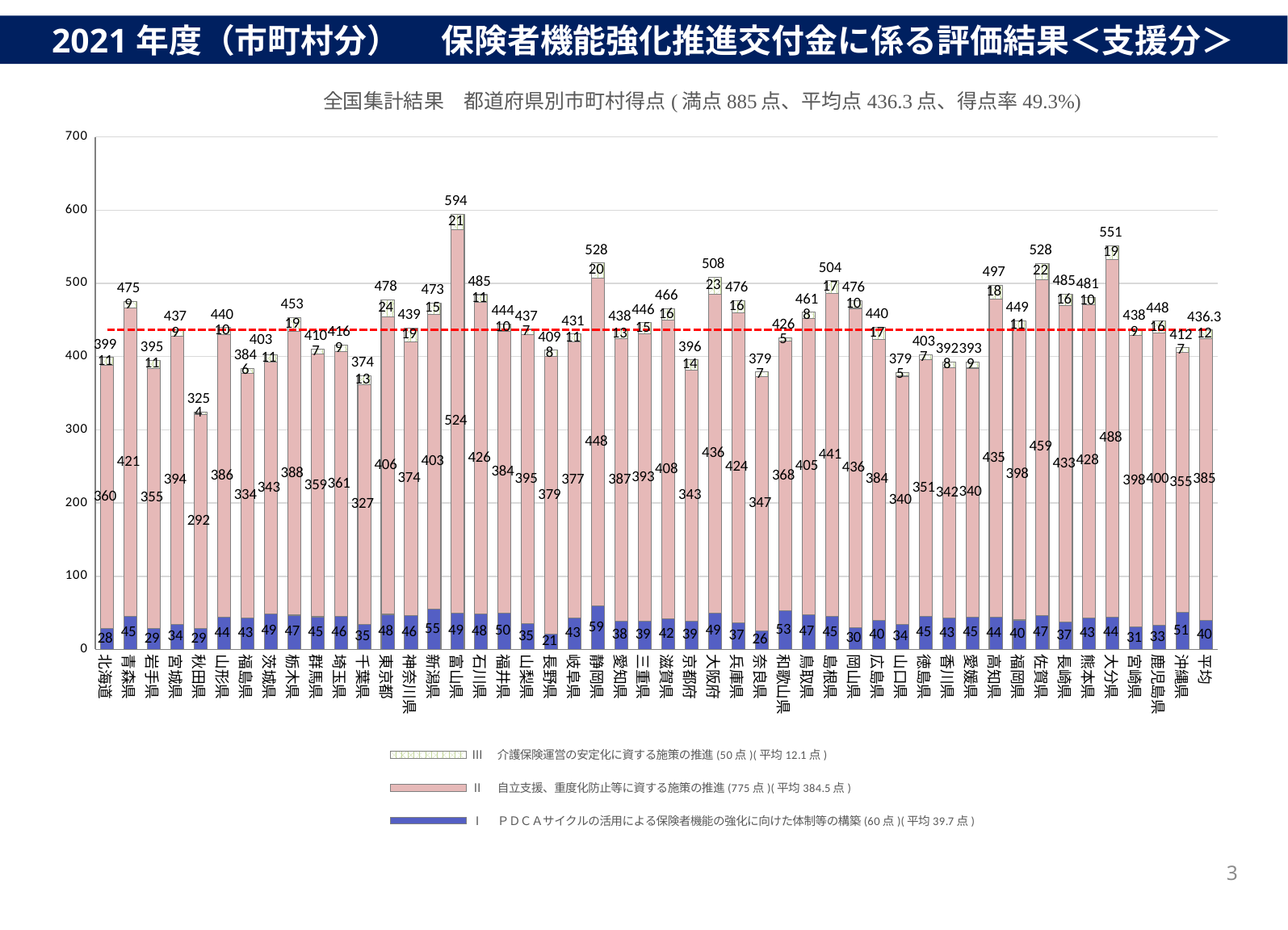
What is the value of segment I (the blue segment) for 北海道? 28 What is the total score shown for 富山県? 594 What kind of chart is shown on the slide? stacked bar chart Is the total score for 秋田県 greater or less than 400? less What is the total score shown for 大分県? 551 Which has a higher total score, 静岡県 or 大阪府? 静岡県 Which prefecture has the lowest total score? 秋田県 What value does the 平均 (average) bar at the far right show as its total? 436.3 How many series does the legend list? 3 What is the difference between the total scores of 富山県 and 秋田県? 269 Which prefecture has the highest total score? 富山県 What is the value of segment II for 秋田県? 292